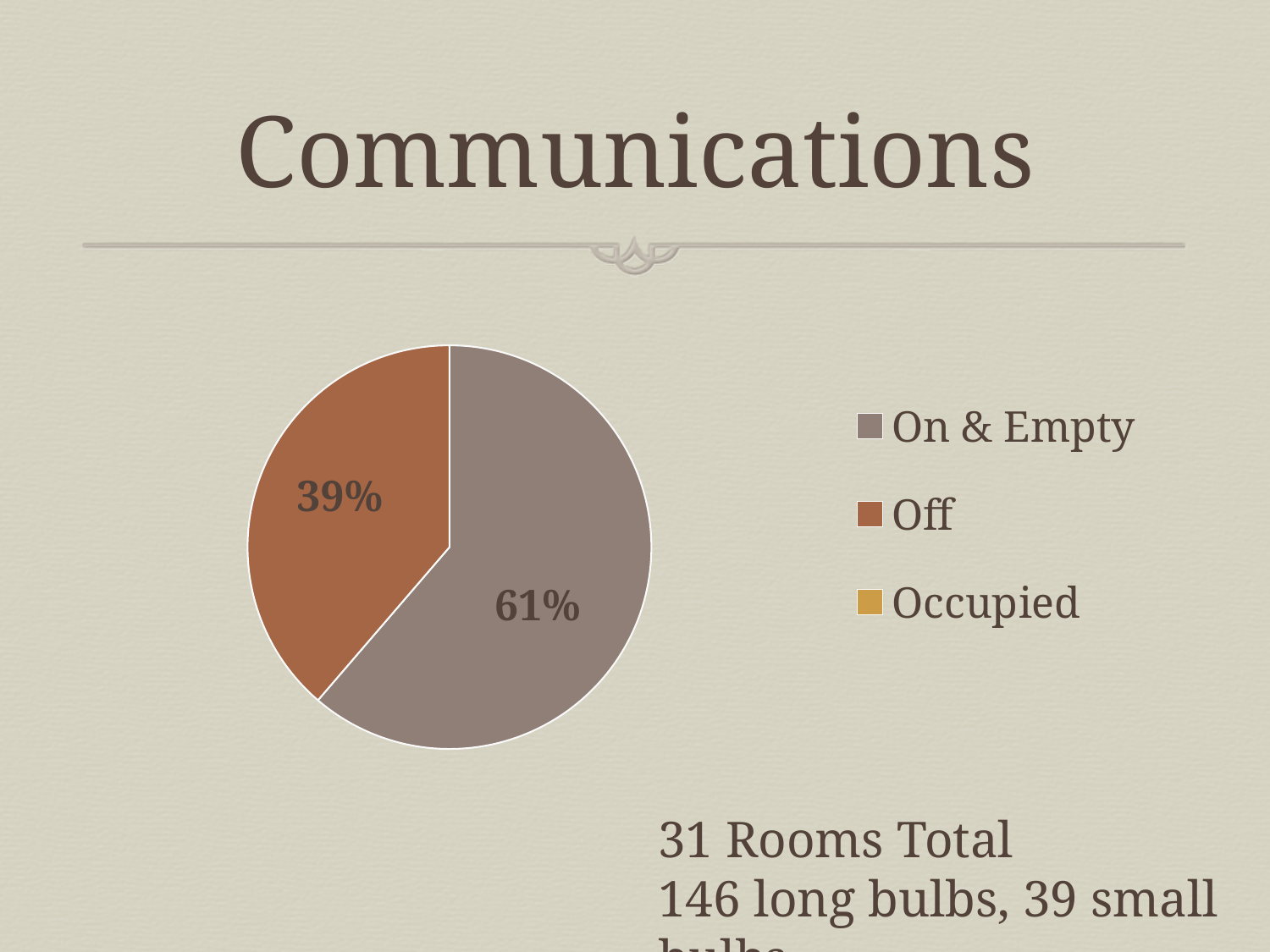
How many entries does the legend list? 3 What kind of chart is shown on the slide? Pie chart Is the share for On & Empty greater or less than 50%? greater What share of the pie does the Off slice represent? 39% Which of the two labelled slices is smaller, On & Empty or Off? Off Which is larger, the On & Empty slice or the Off slice? On & Empty What is the difference in percentage points between the On & Empty slice and the Off slice? 22 percentage points What share of the pie does the On & Empty slice represent? 61% Which legend entry is shown in orange-brown? Off Which category has the largest slice of the pie? On & Empty What is the title of the slide containing the pie chart? Communications How many slices with percentage labels are visible in the pie? 2